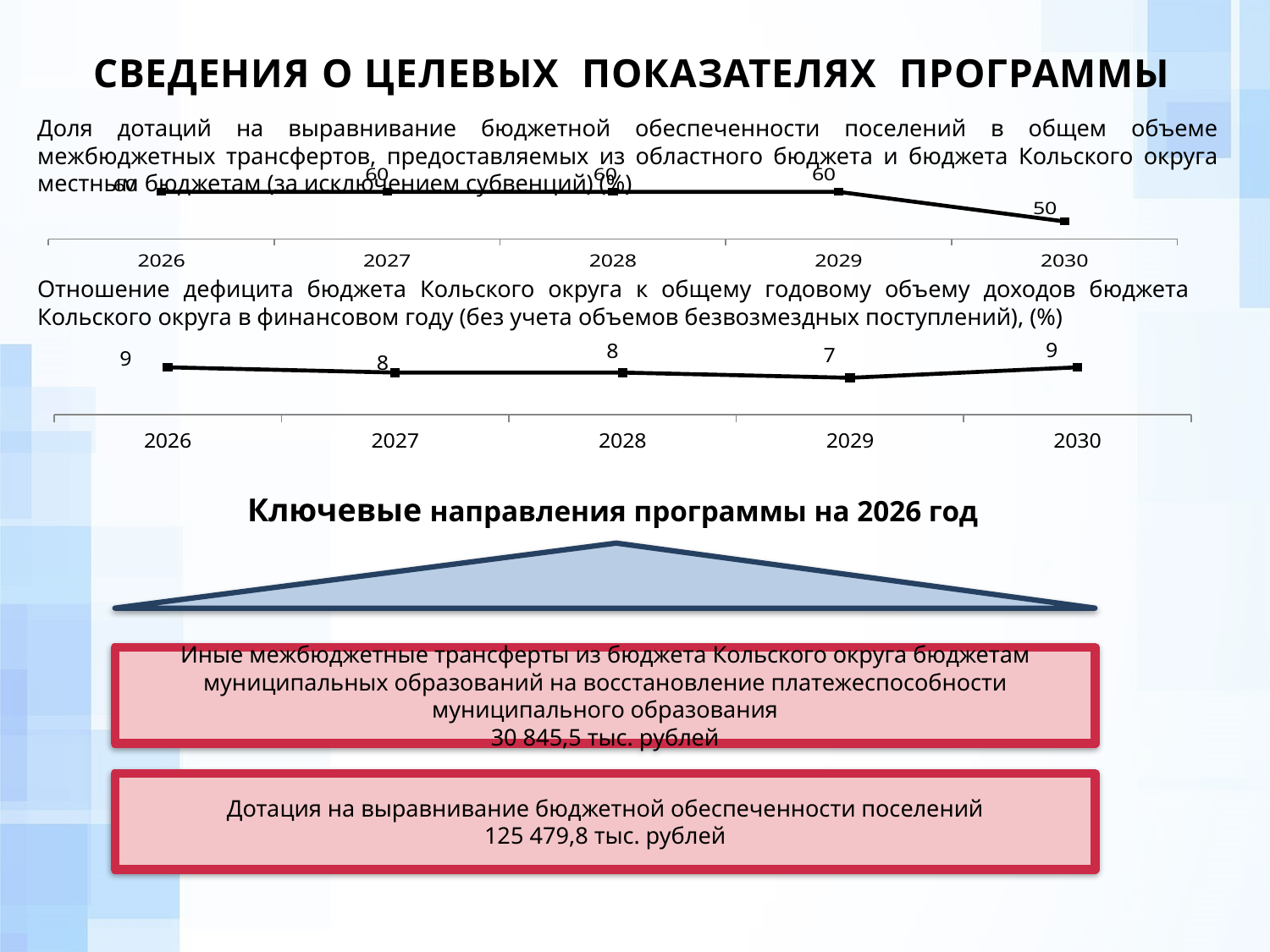
In the top chart (share of equalization grants), how many years are plotted on the x axis? 5 In the top chart (share of equalization grants), do the values rise or fall from 2029 to 2030? fall In the bottom chart (budget deficit ratio), which year has the lowest value? 2029 In the top chart (share of equalization grants), what is the value for 2030? 50 In the top chart (share of equalization grants), what is the value for 2028? 60 In the top chart (share of equalization grants), which year has the lowest value? 2030 In the bottom chart (budget deficit ratio), what is the value for 2026? 9 In the top chart (share of equalization grants), what is the difference between the values for 2029 and 2030? 10 In the bottom chart (budget deficit ratio), what is the difference between the values for 2026 and 2029? 2 In the bottom chart (budget deficit ratio), what is the value for 2029? 7 In the bottom chart (budget deficit ratio), is the value for 2030 larger or smaller than the value for 2029? larger What type of chart is the bottom chart (budget deficit ratio)? line chart